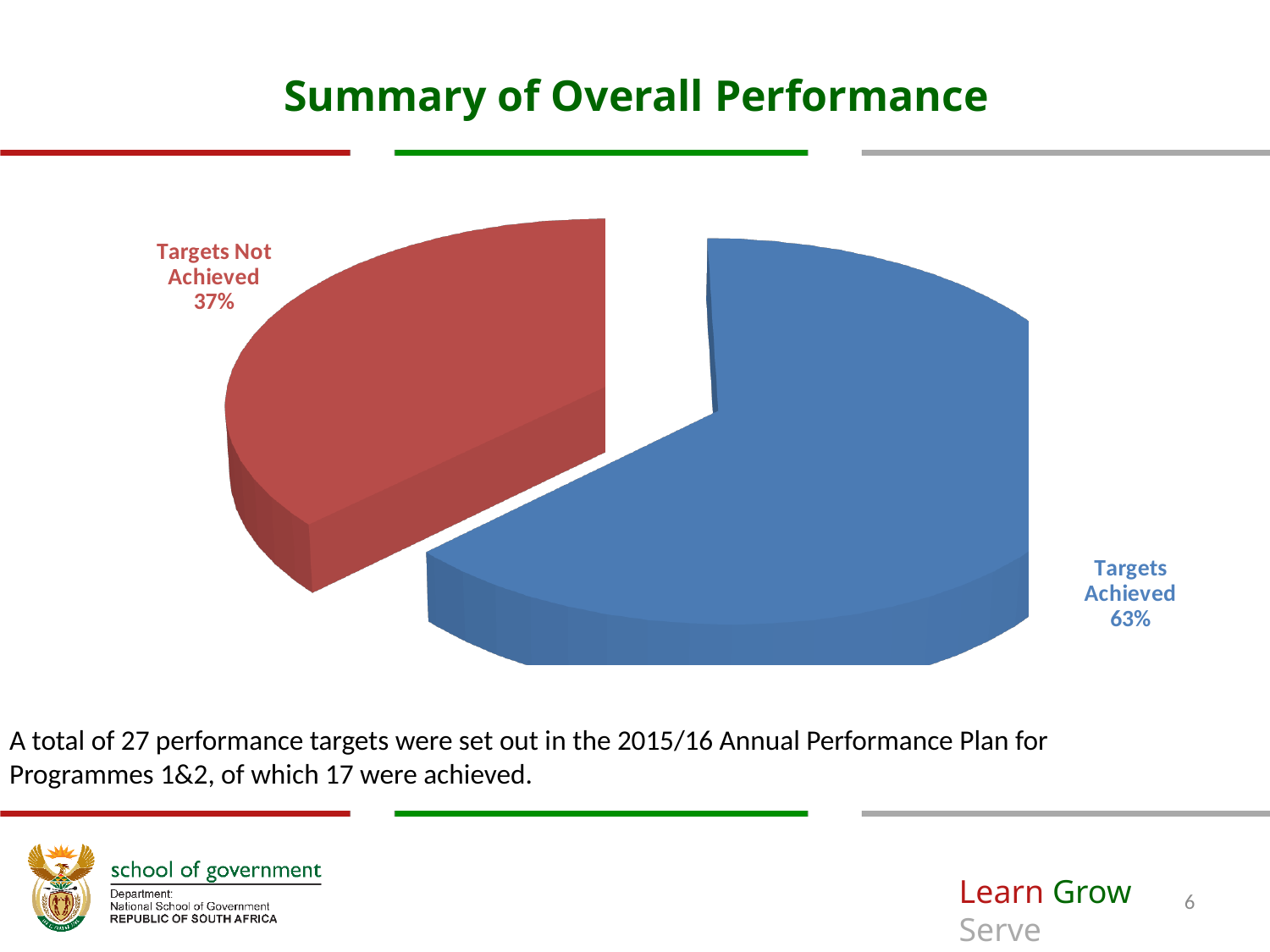
How many slices does the pie chart have? 2 Which is larger, the share of Targets Achieved or the share of Targets Not Achieved? Targets Achieved What kind of chart is shown on the slide? pie chart What is the title of the slide containing the pie chart? Summary of Overall Performance What is the difference in percentage points between Targets Achieved and Targets Not Achieved? 26 What share of the pie does the Targets Not Achieved slice represent? 37% What percentage of targets were achieved according to the pie chart? 63% What percentage of targets were not achieved according to the pie chart? 37% Which slice of the pie chart is the smallest? Targets Not Achieved Which slice of the pie chart is the largest? Targets Achieved What colour is the Targets Achieved slice in the pie chart? blue